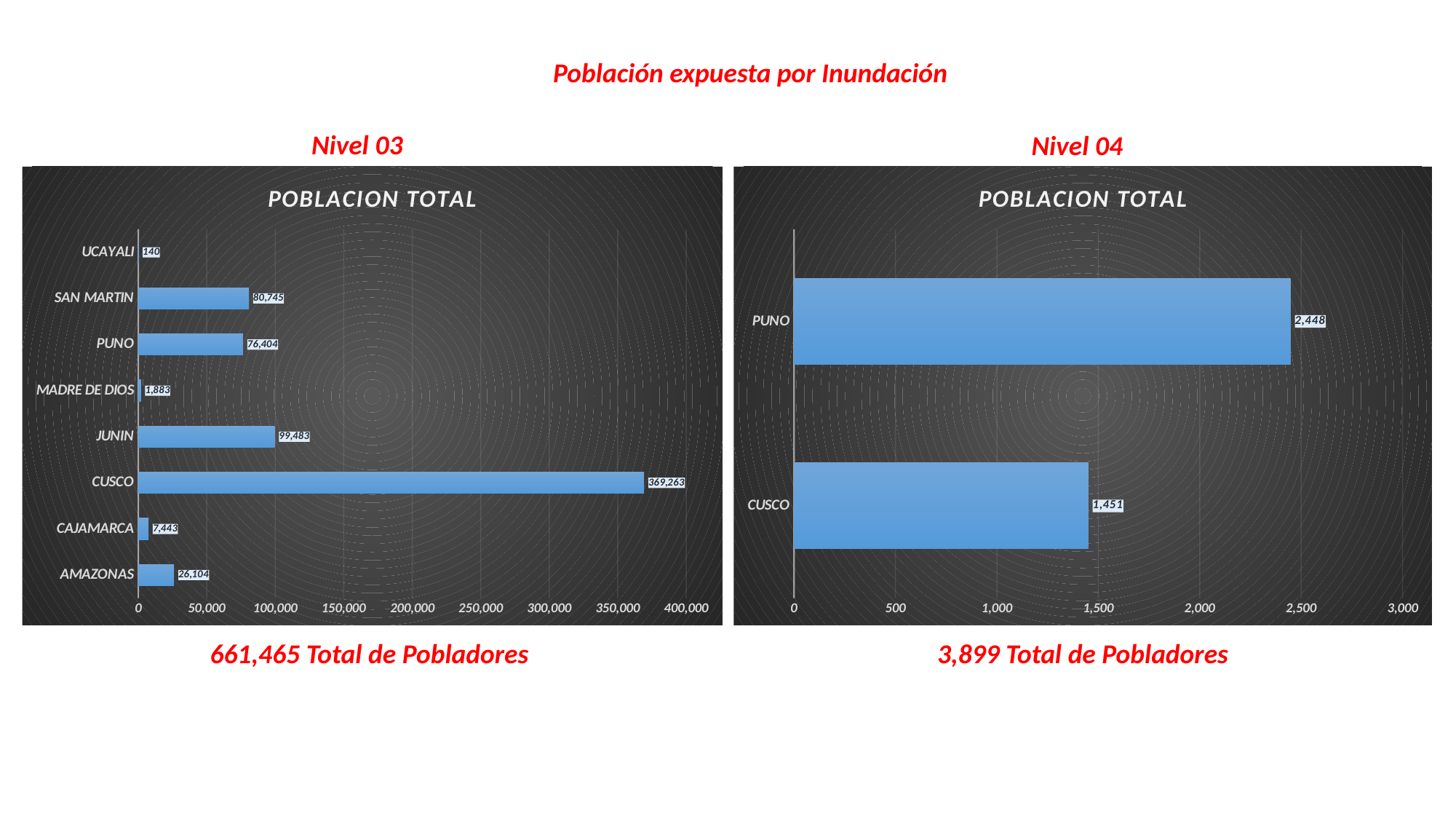
In the Nivel 03 chart, which category has the highest value? CUSCO In the Nivel 04 chart, what is the difference between the values for PUNO and CUSCO? 997 In the Nivel 03 chart, which is larger, the value for AMAZONAS or the value for CAJAMARCA? AMAZONAS In the Nivel 03 chart, what is the value for MADRE DE DIOS? 1,883 In the Nivel 03 chart, what is the value for CUSCO? 369,263 In the Nivel 03 chart, what is the difference between the values for CUSCO and JUNIN? 269,780 In the Nivel 04 chart, which category has the lowest value? CUSCO How many categories are shown in the Nivel 03 chart? 8 What kind of chart is the Nivel 04 chart? Bar chart In the Nivel 03 chart, what is the value for SAN MARTIN? 80,745 In the Nivel 04 chart, what is the value for PUNO? 2,448 In the Nivel 03 chart, which category has the lowest value? UCAYALI